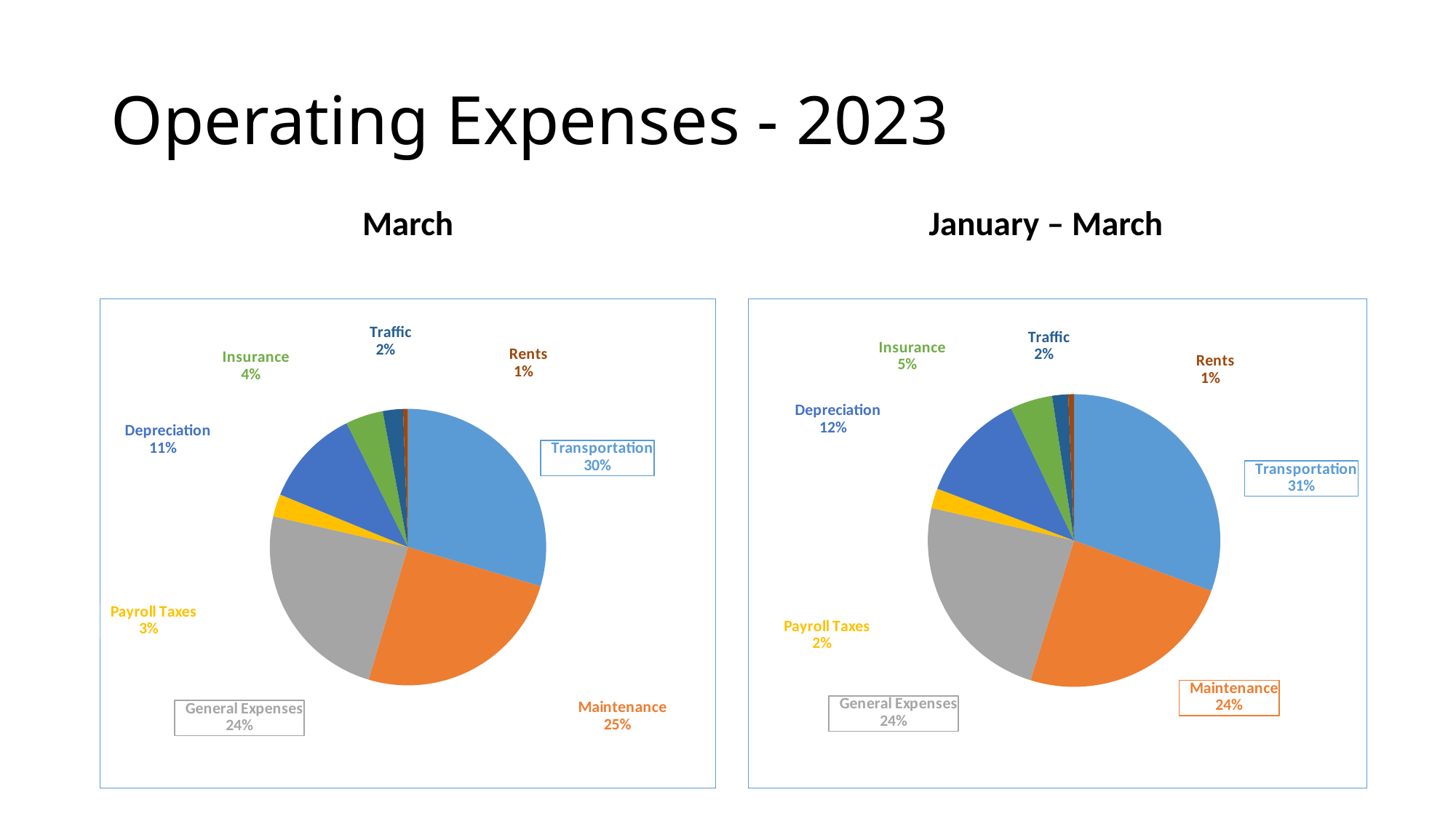
In the January – March chart, which category has the smallest share? Rents In the January – March chart, which is larger, Insurance or Payroll Taxes? Insurance In the March chart, which category has the largest share? Transportation In the March chart, what share of operating expenses is Payroll Taxes? 3% In the January – March chart, what is the difference between the Transportation and Maintenance shares? 7% In the March chart, what is the difference between the Maintenance and General Expenses shares? 1% What is the title of the chart on the right side of the slide? January – March How many categories are shown in the March chart? 8 What kind of chart is the January – March chart? Pie chart In the March chart, what share of operating expenses is Transportation? 30% In the March chart, what share of operating expenses is Insurance? 4%